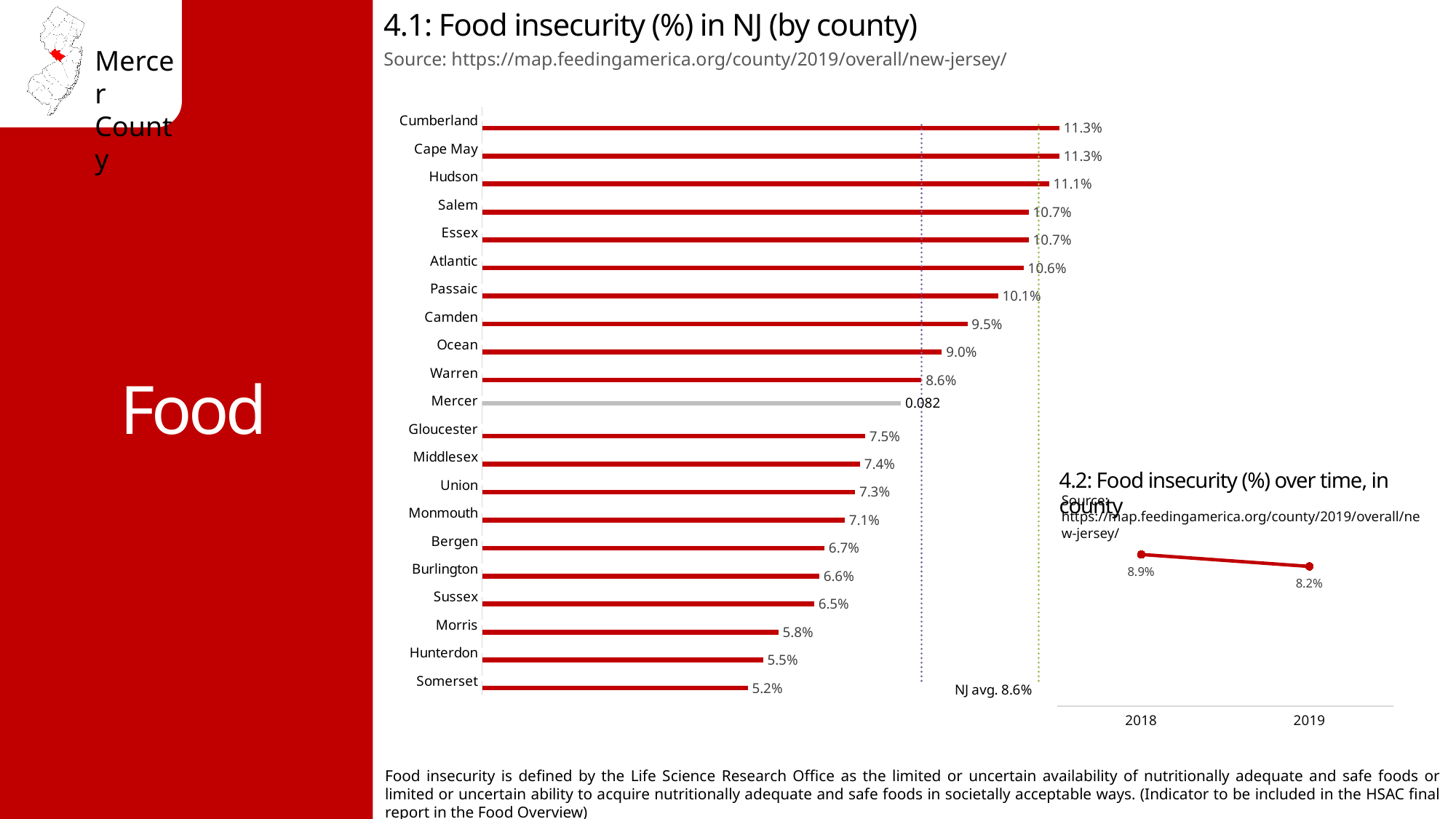
In chart 4.1 (Food insecurity (%) in NJ by county), what is the value for Somerset? 5.2% In chart 4.1 (Food insecurity (%) in NJ by county), how many counties are plotted? 21 In chart 4.2 (Food insecurity (%) over time, in county), what is the difference between 2018 and 2019? 0.7% What kind of chart is chart 4.1 (Food insecurity (%) in NJ by county)? Bar chart In chart 4.1 (Food insecurity (%) in NJ by county), what is the difference between Cumberland and Somerset? 6.1% In chart 4.1 (Food insecurity (%) in NJ by county), which county has the lowest value? Somerset In chart 4.1 (Food insecurity (%) in NJ by county), which is larger, Camden or Ocean? Camden In chart 4.1 (Food insecurity (%) in NJ by county), what is the value for Hudson? 11.1% In chart 4.1 (Food insecurity (%) in NJ by county), what data label is shown for Mercer? 0.082 In chart 4.2 (Food insecurity (%) over time, in county), does the value rise or fall from 2018 to 2019? Fall In chart 4.2 (Food insecurity (%) over time, in county), what is the value for 2018? 8.9% In chart 4.1 (Food insecurity (%) in NJ by county), what NJ average is labelled on the chart? NJ avg. 8.6%